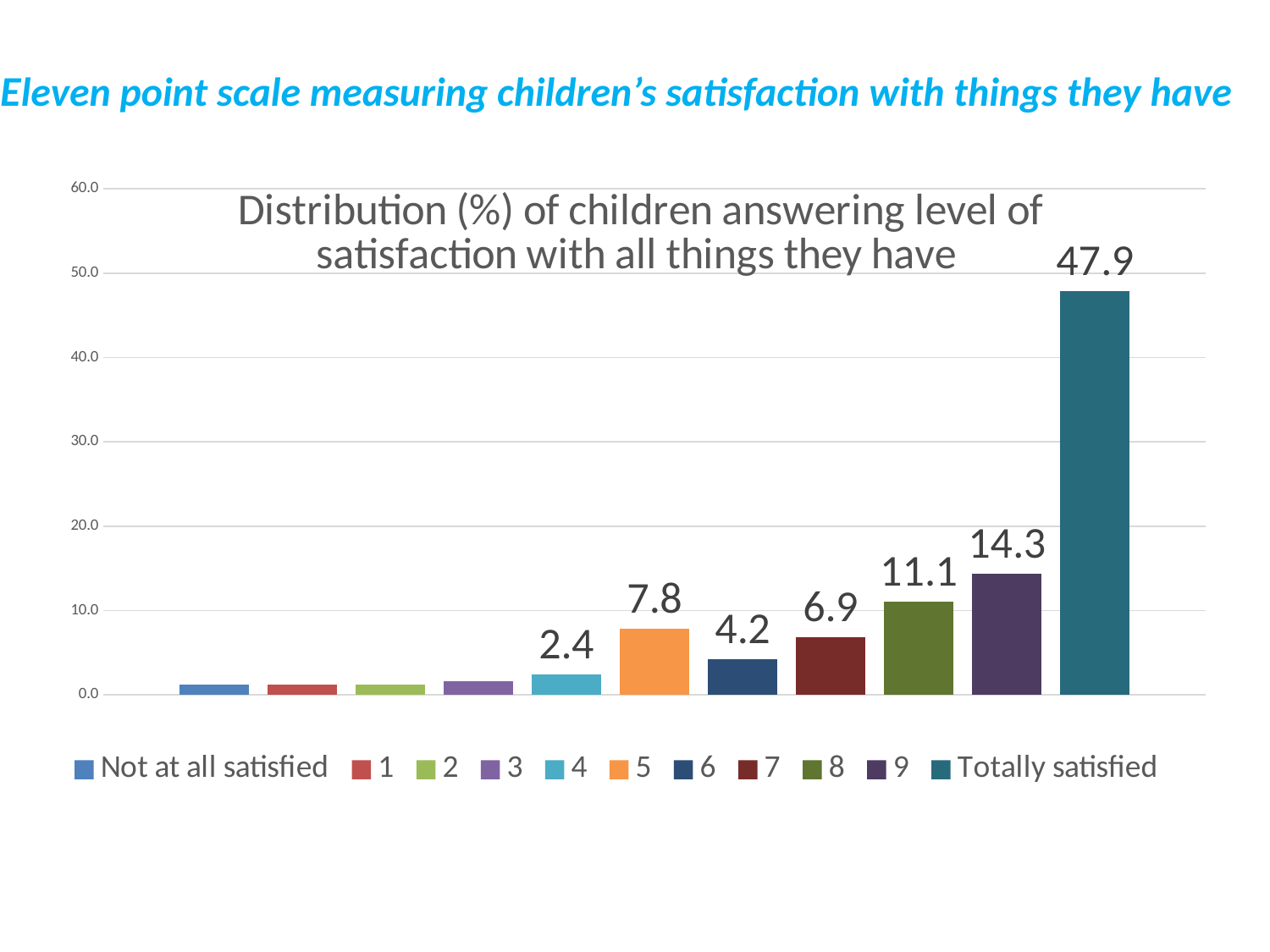
What is the value shown for the category 8? 11.1 What kind of chart is shown on the slide? bar chart Is the value for "Not at all satisfied" greater or less than 10.0? less Which has the larger value, category 5 or category 6? 5 What percentage of children answered "Totally satisfied"? 47.9 What is the title of the chart? Distribution (%) of children answering level of satisfaction with all things they have What is the value shown for the category 5? 7.8 Which category has the highest value? Totally satisfied What is the difference between the value for "Totally satisfied" and the value for 9? 33.6 What is the value shown for the category 9? 14.3 What is the difference between the value for 8 and the value for 7? 4.2 How many categories are plotted in the chart? 11